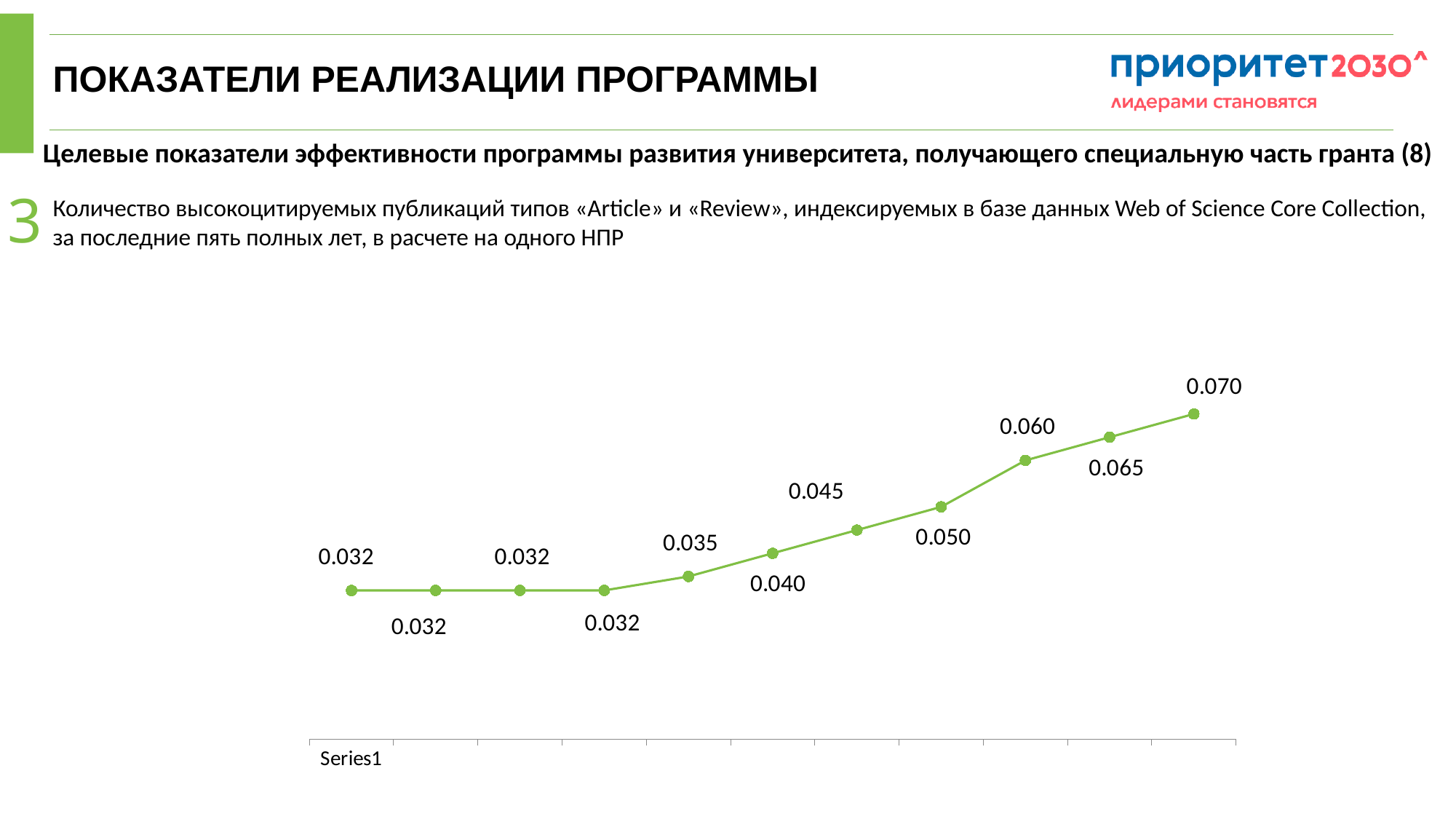
Do the values on the line chart rise or fall from left to right? rise What label appears on the x axis of the line chart? Series1 What is the value of the first data point on the line chart? 0.032 What is the difference between the ninth data point (0.060) and the eighth data point (0.050)? 0.010 What kind of chart is shown on the slide? line chart What is the difference between the last data point and the first data point on the line chart? 0.038 How many data points are plotted on the line chart? 11 What is the value of the fifth data point on the line chart? 0.035 How many of the data points on the line chart have the value 0.032? 4 What is the highest value shown on the line chart? 0.070 What is the lowest value shown on the line chart? 0.032 What is the value of the last data point on the line chart? 0.070